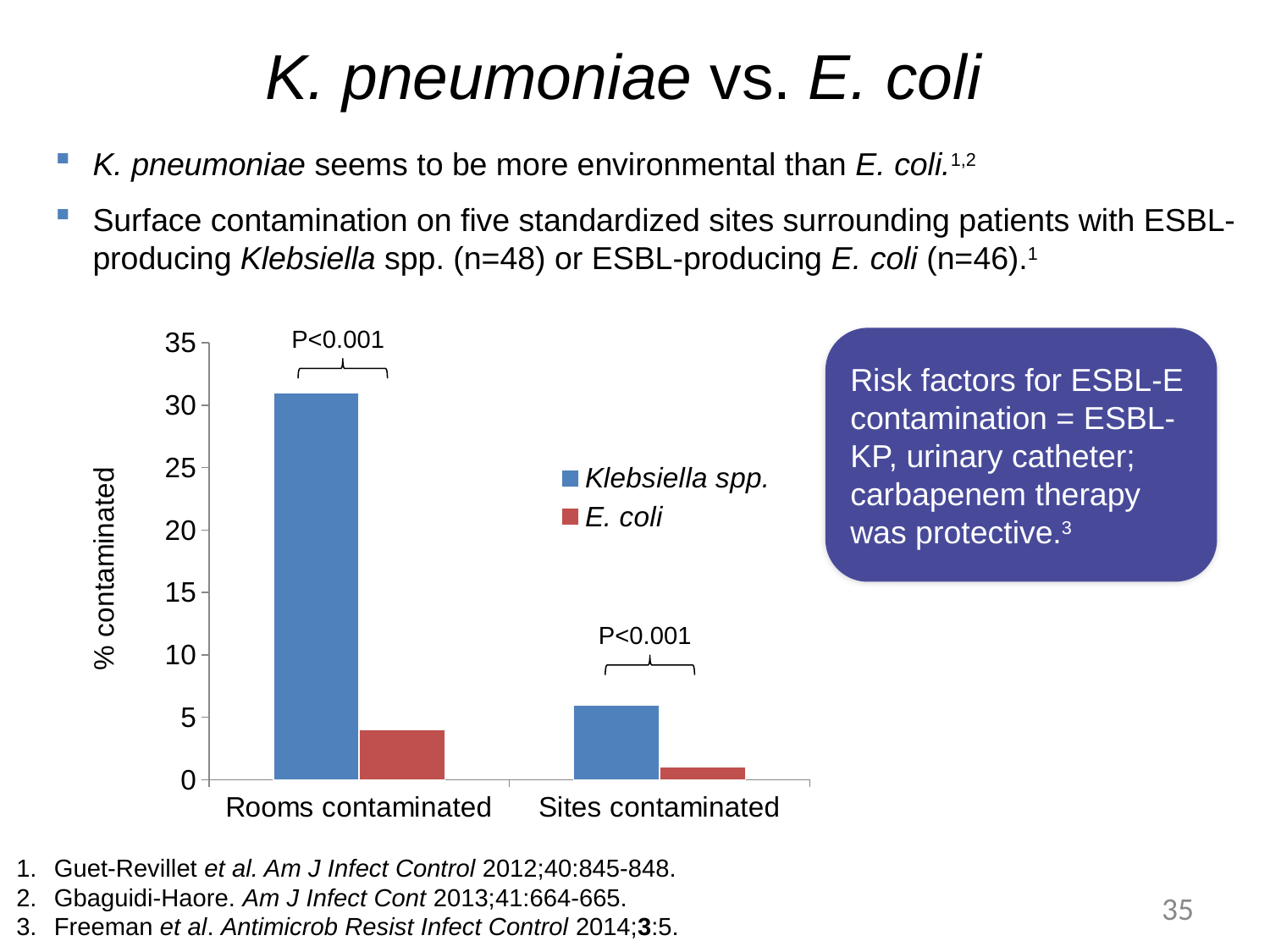
What colour are the E. coli bars in the chart? red Is the value for Klebsiella spp. in Rooms contaminated greater or less than 30? greater Which series has the higher value for Sites contaminated, Klebsiella spp. or E. coli? Klebsiella spp. Which series has the higher value for Rooms contaminated, Klebsiella spp. or E. coli? Klebsiella spp. How many series does the chart legend list? 2 Is the value for E. coli in Rooms contaminated greater or less than 5? less What kind of chart is shown on the slide? bar chart Which bar in the chart is the shortest? E. coli, Sites contaminated What is the label on the y axis of the chart? % contaminated Is the value for Klebsiella spp. in Sites contaminated greater or less than 10? less How many categories are shown on the x axis of the chart? 2 Which bar in the chart is the tallest? Klebsiella spp., Rooms contaminated